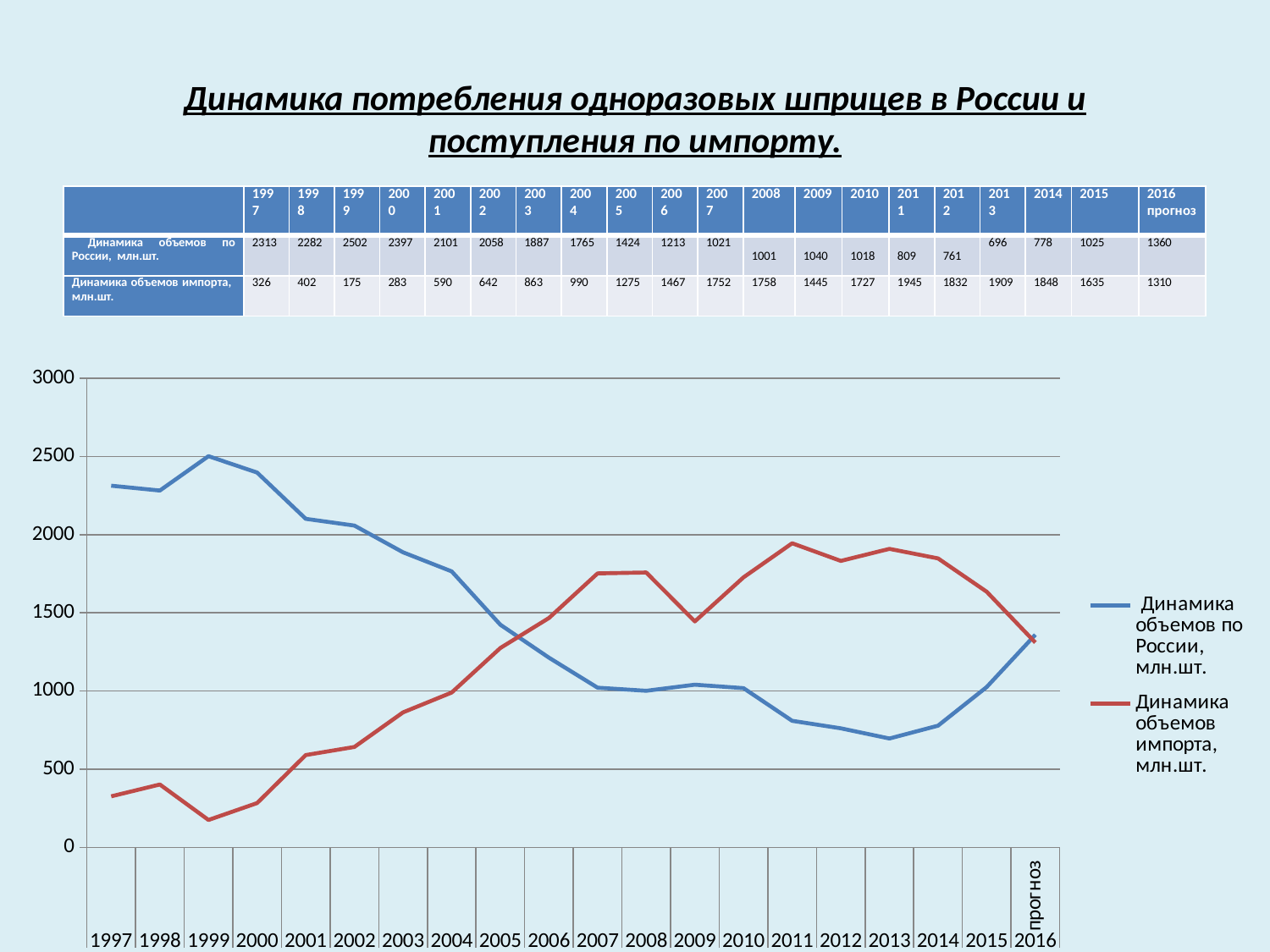
Which series has the larger value in 2010: Динамика объемов по России or Динамика объемов импорта? Динамика объемов импорта, млн.шт. How many years (points) are plotted on the x axis of the chart? 20 What kind of chart is shown on the slide? line chart How many series does the chart legend list? 2 What is the difference between Динамика объемов по России and Динамика объемов импорта in 1997? 1987 Is the value of Динамика объемов по России, млн.шт. for 2005 greater or less than 1500? less What is the value of Динамика объемов по России, млн.шт. for 1999? 2502 In which year is Динамика объемов по России, млн.шт. at its highest? 1999 What is the forecast value for 2016 of Динамика объемов импорта, млн.шт.? 1310 In which year is Динамика объемов импорта, млн.шт. at its lowest? 1999 In which year is Динамика объемов по России, млн.шт. at its lowest? 2013 What is the value of Динамика объемов импорта, млн.шт. for 2011? 1945